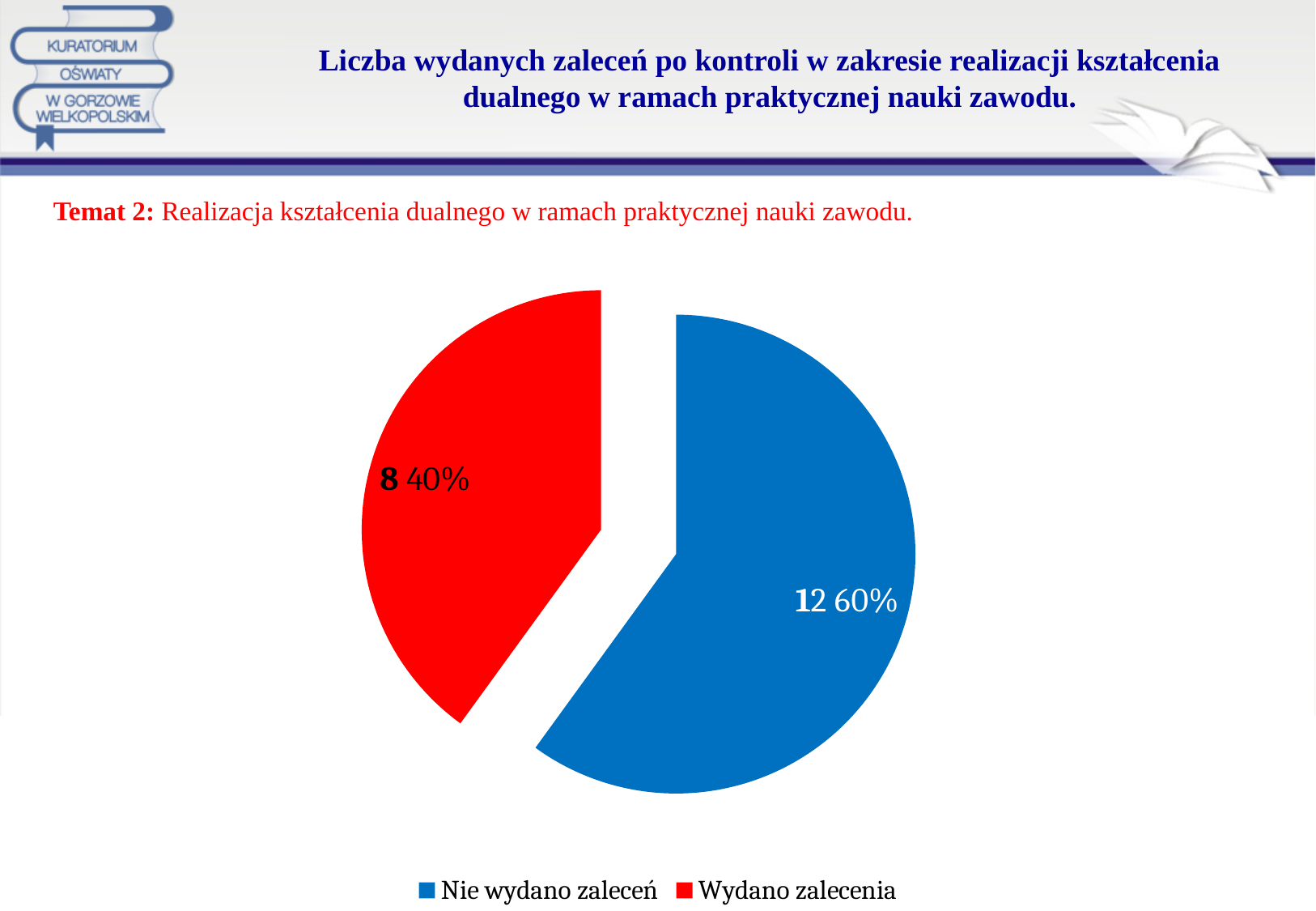
How many slices does the pie chart have? 2 What kind of chart is shown on the slide? pie chart Which is larger, the value for "Nie wydano zaleceń" or "Wydano zalecenia"? Nie wydano zaleceń What share of the pie does "Wydano zalecenia" represent? 40% What is the value for "Wydano zalecenia"? 8 What colour is the slice for "Wydano zalecenia"? red What is the value for "Nie wydano zaleceń"? 12 What share of the pie does "Nie wydano zaleceń" represent? 60% How many entries does the legend list? 2 What is the difference between the values for "Nie wydano zaleceń" and "Wydano zalecenia"? 4 Which category has the smallest slice? Wydano zalecenia Which category has the largest slice? Nie wydano zaleceń